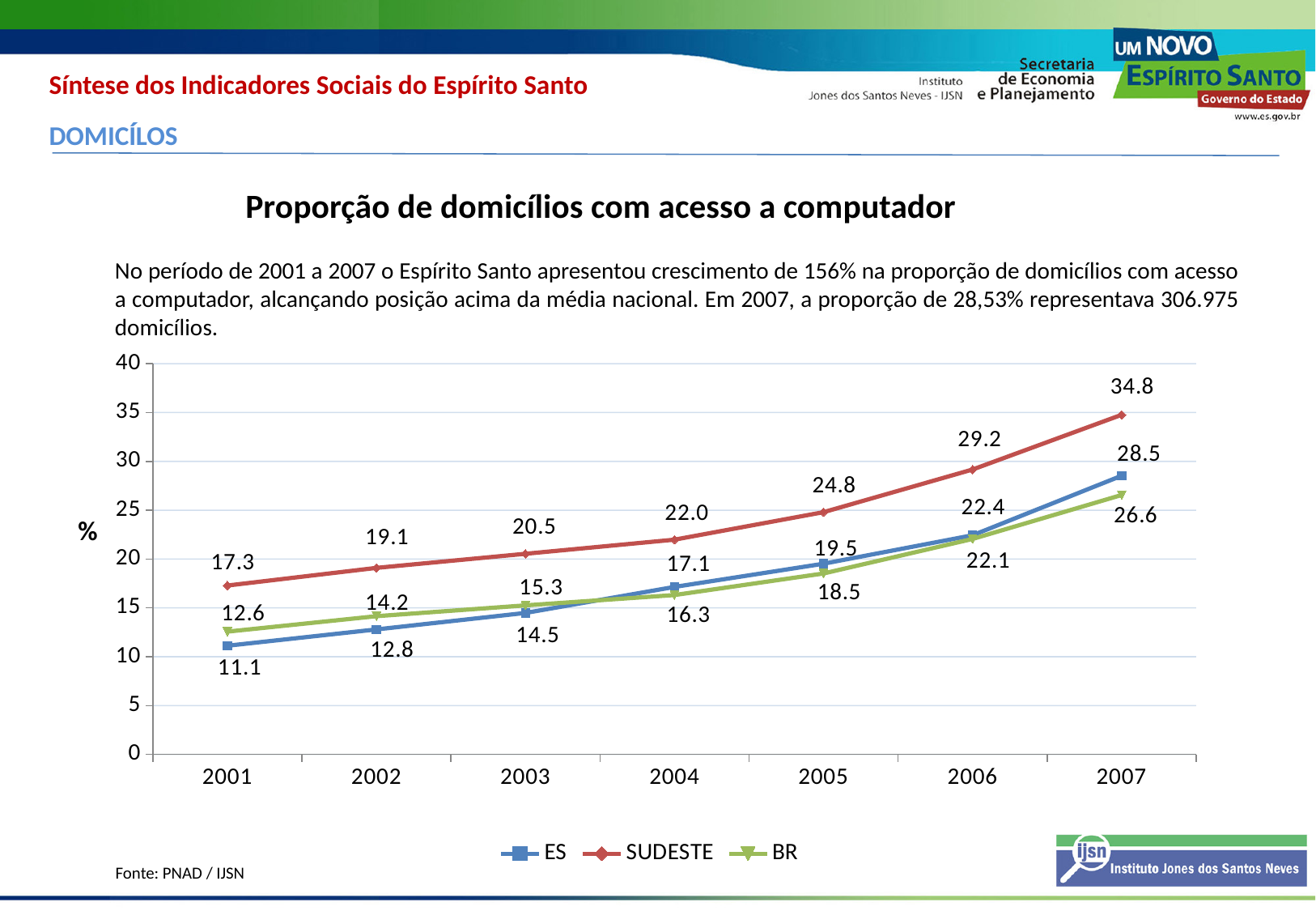
What is the value for ES in 2007? 28.5 What is the difference between the SUDESTE and ES values in 2007? 6.3 In which year is the SUDESTE series highest? 2007 What is the value for BR in 2001? 12.6 In which year is the ES series lowest? 2001 Which is larger in 2003, the ES value or the BR value? BR How many years are plotted on the x axis? 7 What is the title of the chart? Proporção de domicílios com acesso a computador Does the ES series rise or fall from 2001 to 2007? rise What type of chart is shown on the slide? line chart How many series does the legend list? 3 What is the value for SUDESTE in 2004? 22.0